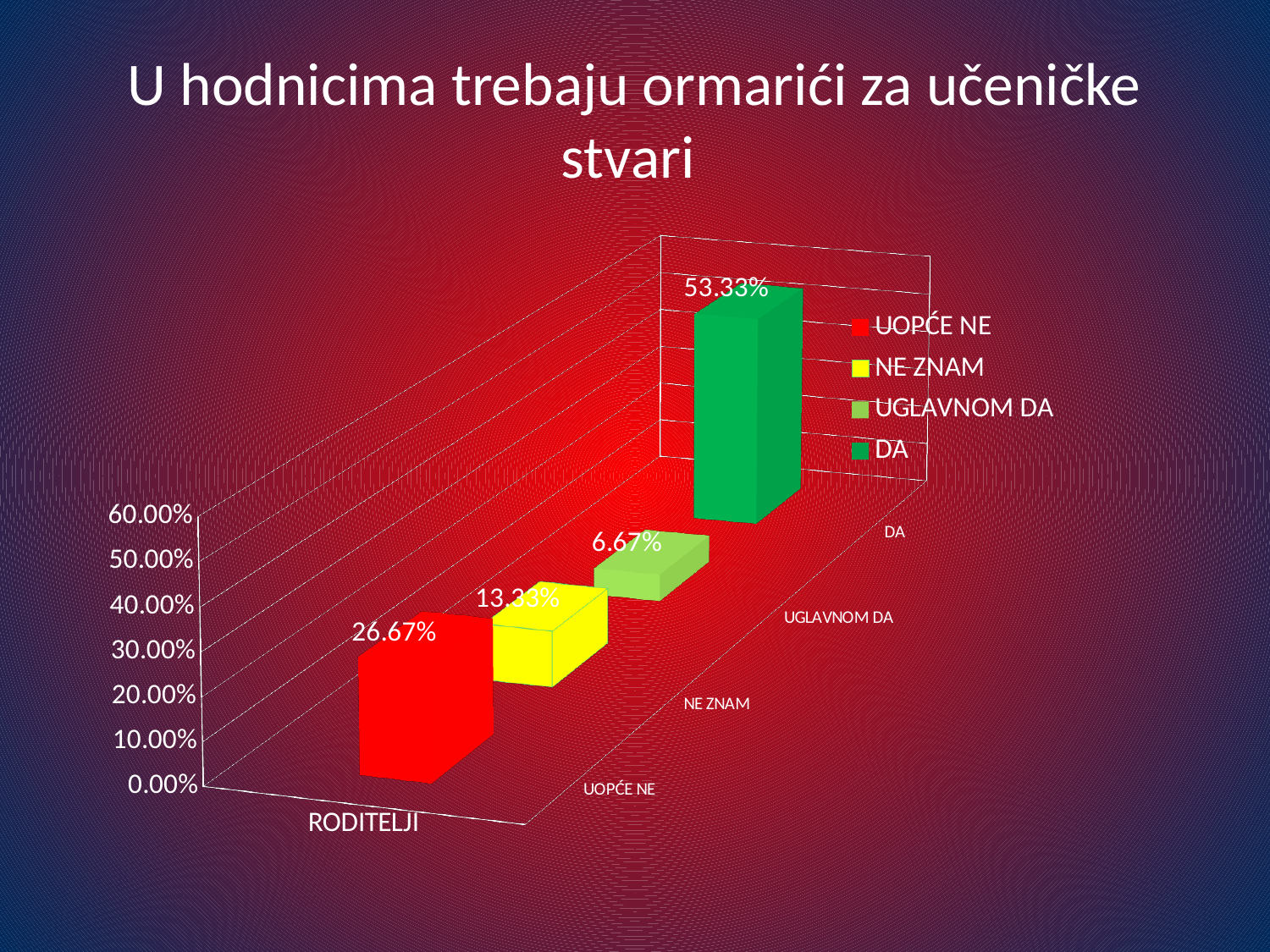
What kind of chart is shown on the slide? bar chart What is the difference between the values for DA and UOPĆE NE? 26.66% What colour is the bar for DA? green Which series has the lowest value? UGLAVNOM DA What is the value for UOPĆE NE? 26.67% What is the value for NE ZNAM? 13.33% What is the title of the chart? U hodnicima trebaju ormarići za učeničke stvari What is the value for UGLAVNOM DA? 6.67% How many series does the legend list? 4 Which is larger, the value for NE ZNAM or the value for UGLAVNOM DA? NE ZNAM Which series has the highest value? DA What is the value for DA? 53.33%